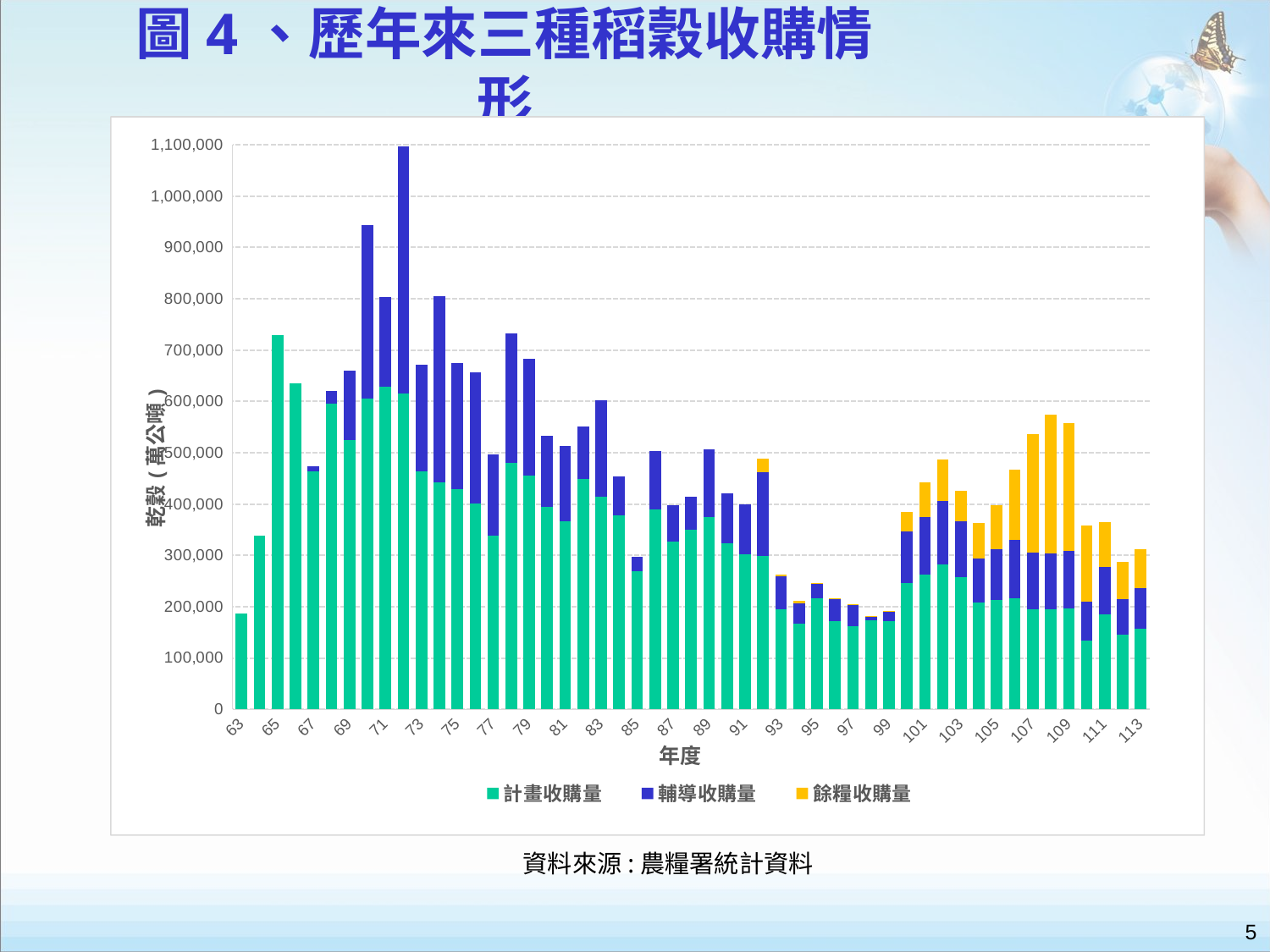
Is the total value for year 109 greater or less than 500,000? greater Which series is shown in yellow in the legend? 餘糧收購量 Is the total value for year 99 greater or less than 200,000? less How many series does the legend list? 3 Which year has the larger total bar, 65 or 67? 65 Is the total value for year 65 greater or less than 700,000? greater Do the total bar heights generally rise or fall from year 73 to year 99? fall What is the label of the x axis? 年度 Which year has the larger total bar, 107 or 111? 107 What kind of chart is shown on the slide? Stacked bar chart